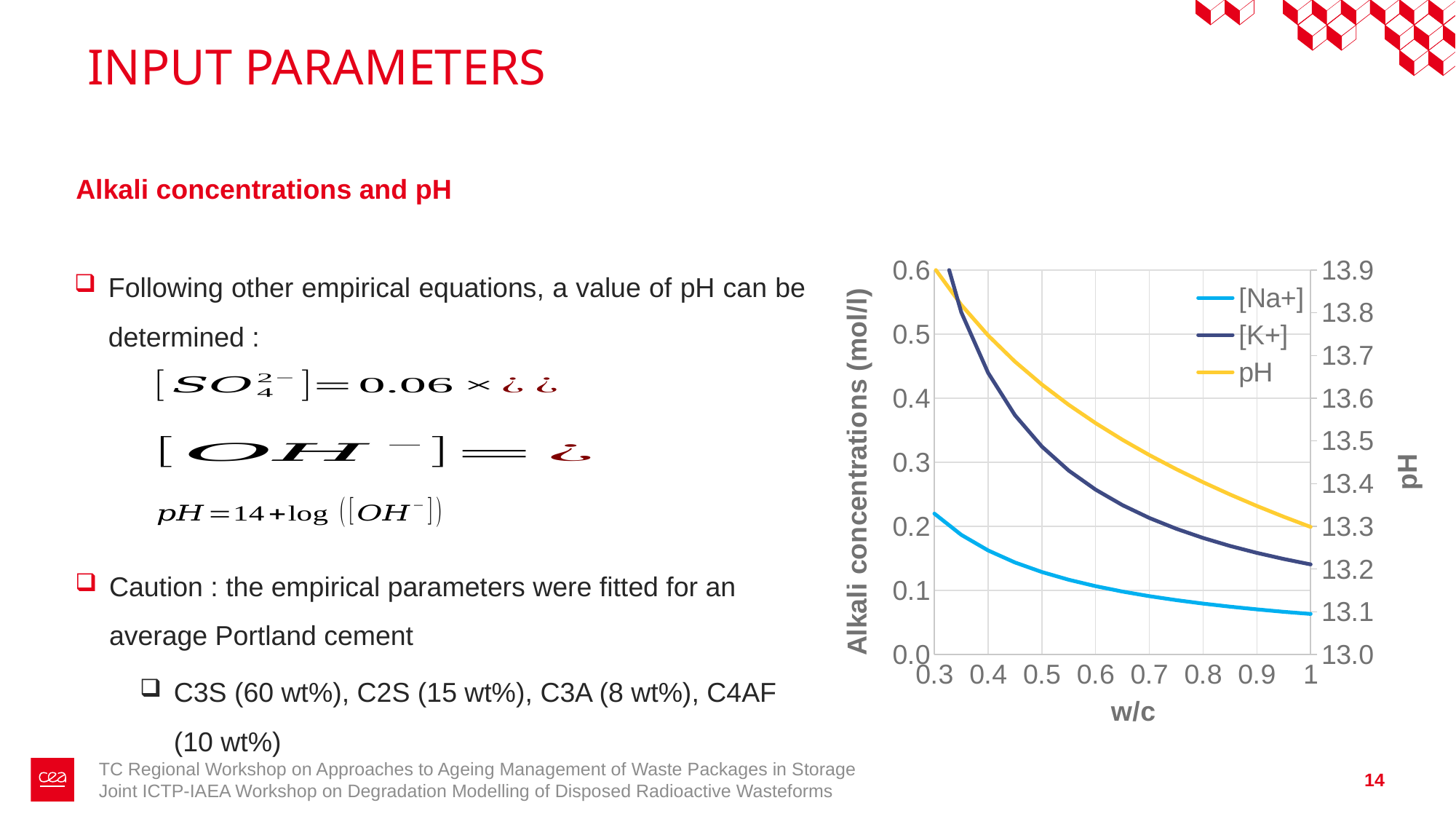
Is the [Na+] value at w/c = 0.3 greater or less than 0.2 mol/l? greater What kind of chart is shown on the slide? line chart How many series does the chart legend list? 3 What are the three series listed in the chart legend? [Na+], [K+], pH Is the [Na+] value at w/c = 1 greater or less than 0.1 mol/l? less Is the pH value at w/c = 0.4 greater or less than 13.7? greater Does the [K+] series rise or fall as w/c increases from 0.3 to 1? fall At w/c = 0.5, which is larger, the [K+] concentration or the [Na+] concentration? [K+] Does the pH series rise or fall as w/c increases? fall What is the label of the x axis of the chart? w/c